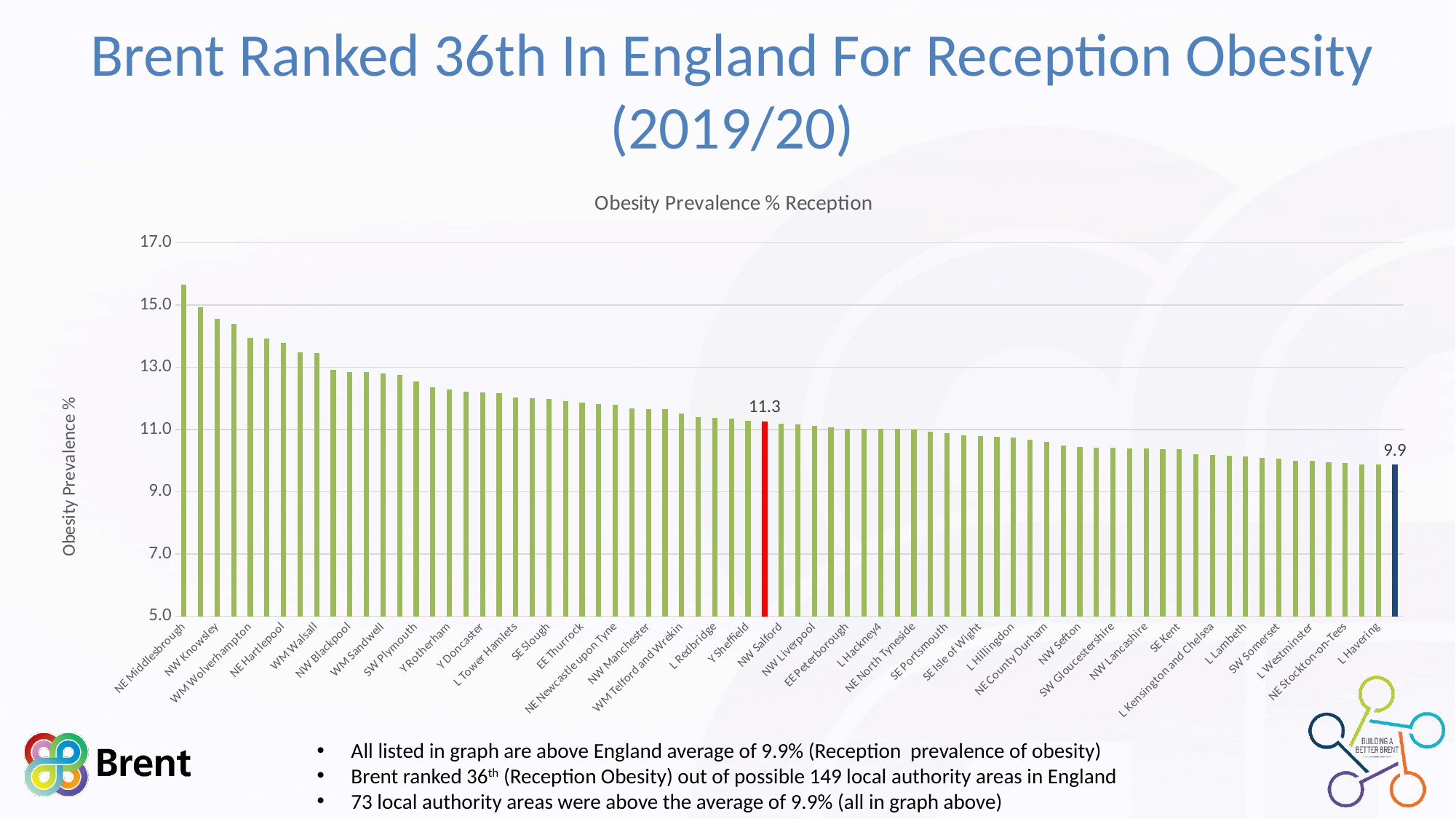
What value is printed above the dark blue bar at the right end of the chart? 9.9 Which local authority has the highest obesity prevalence in the chart? NE Middlesbrough What kind of chart is shown on the slide? bar chart Do the bar values rise or fall moving from left to right along the x axis? fall Which has the higher obesity prevalence, NE Middlesbrough or L Havering? NE Middlesbrough Is the value for NE Middlesbrough greater or less than 15.0? greater Is the value for WM Walsall greater or less than 13.0? greater What value is printed above the red bar in the chart? 11.3 Is the value for SE Kent greater or less than 11.0? less What is the difference between the value of the red bar (11.3) and the dark blue bar (9.9)? 1.4 What is the title of the chart? Obesity Prevalence % Reception What is the label on the vertical axis of the chart? Obesity Prevalence %